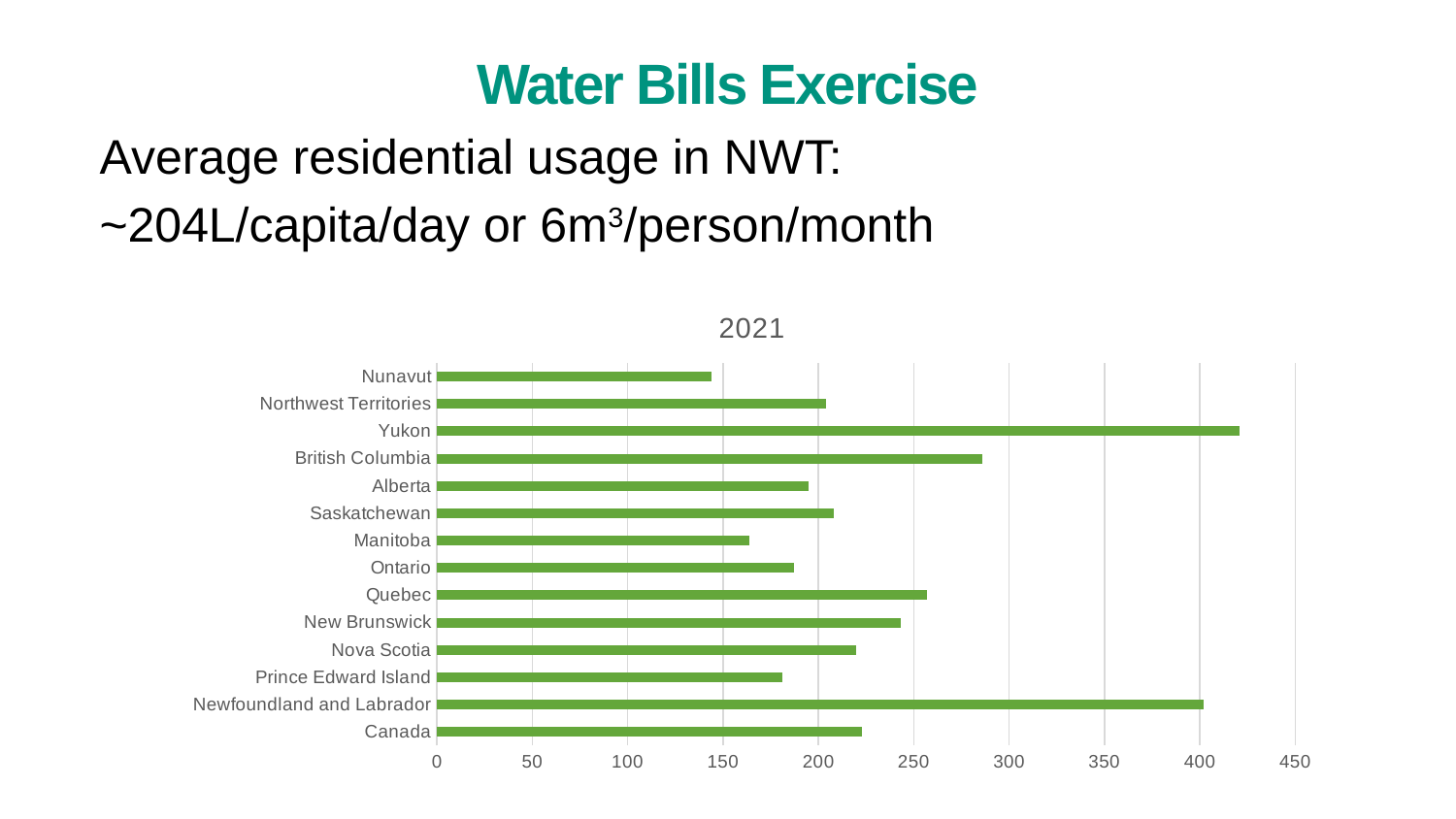
Which has a larger value, Manitoba or New Brunswick? New Brunswick Is the value for Yukon greater or less than 400? greater What is the title of the chart? 2021 Which category has the highest value in the chart? Yukon Is the value for Manitoba greater or less than 200? less Which has a larger value, British Columbia or Quebec? British Columbia Is the value for Newfoundland and Labrador greater or less than 350? greater Which category has the lowest value in the chart? Nunavut What kind of chart is shown on the slide? bar chart How many categories (provinces/territories plus Canada) are plotted in the chart? 14